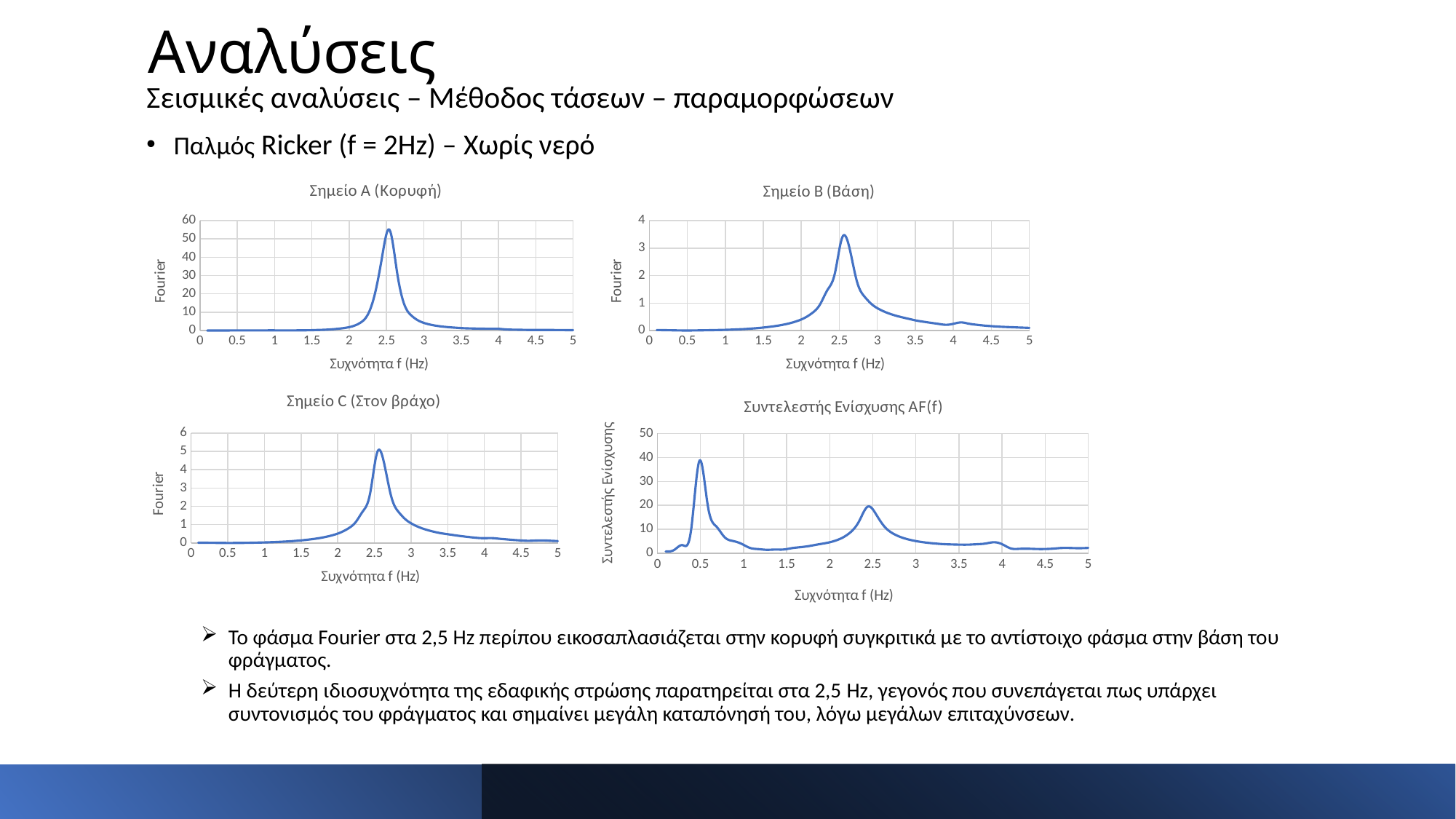
In the chart 'Συντελεστής Ενίσχυσης AF(f)', do the values rise or fall between 0.5 Hz and 1 Hz? fall In the chart 'Συντελεστής Ενίσχυσης AF(f)', is the value at 2.5 Hz greater or less than 30? less In the chart 'Σημείο C (Στον βράχο)', is the peak value greater or less than 4? greater How many charts are shown on the slide? 4 In the chart 'Σημείο A (Κορυφή)', is the peak value greater or less than 50? greater What kind of chart is 'Σημείο A (Κορυφή)'? line chart In the chart 'Σημείο A (Κορυφή)', do the values rise or fall between 2.5 Hz and 3.5 Hz? fall What is the x-axis label of the chart 'Σημείο A (Κορυφή)'? Συχνότητα f (Hz) What is the y-axis label of the chart 'Συντελεστής Ενίσχυσης AF(f)'? Συντελεστής Ενίσχυσης